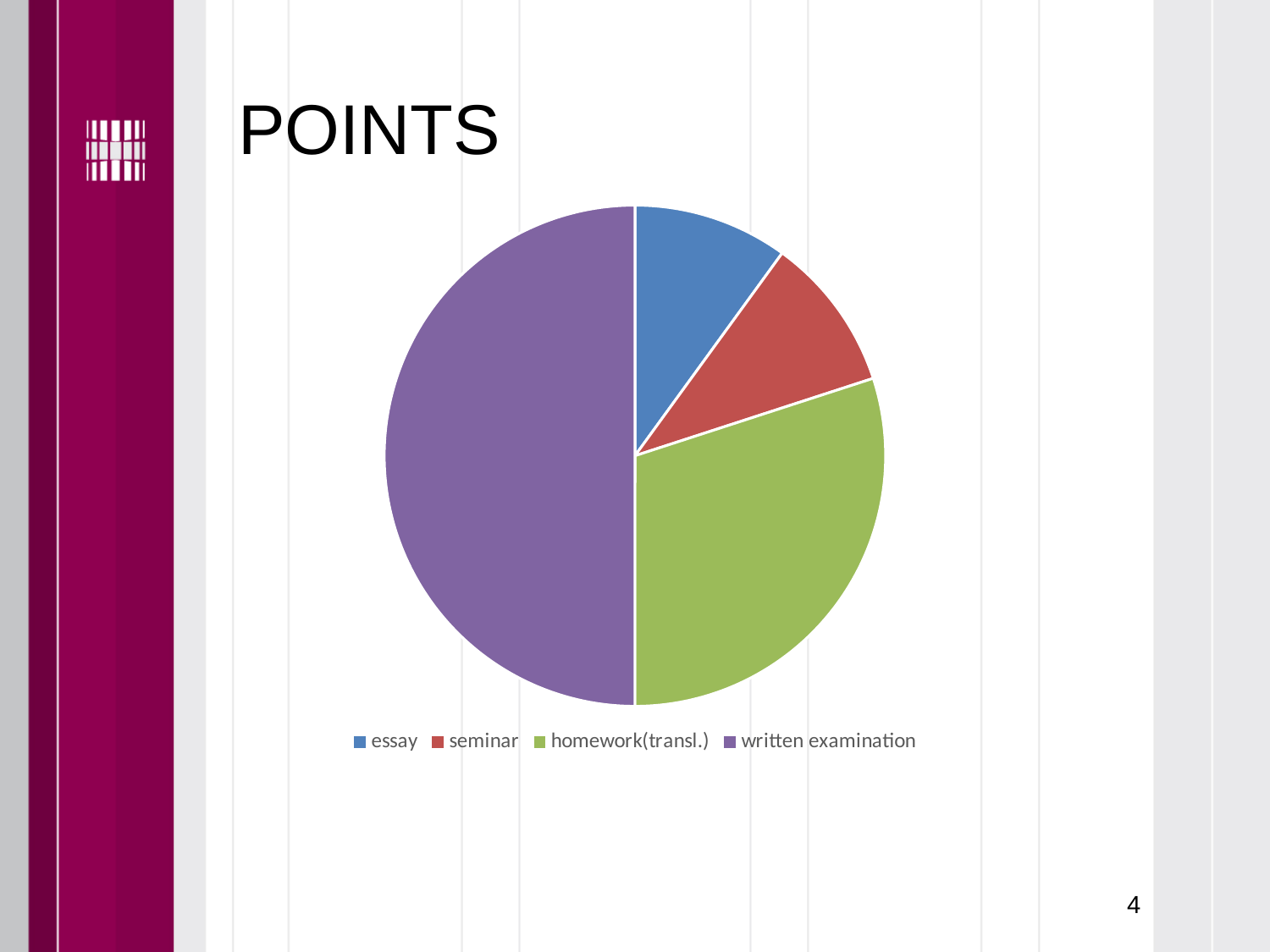
What colour is the essay slice in the pie chart? blue Which category has the largest slice of the pie chart? written examination How many slices does the pie chart have? 4 Which category is shown in purple in the pie chart? written examination How many entries does the legend of the pie chart list? 4 Which slice is larger, homework(transl.) or seminar? homework(transl.) Which slice is larger, homework(transl.) or essay? homework(transl.) Which slice is larger, written examination or seminar? written examination What kind of chart is shown on the slide? pie chart